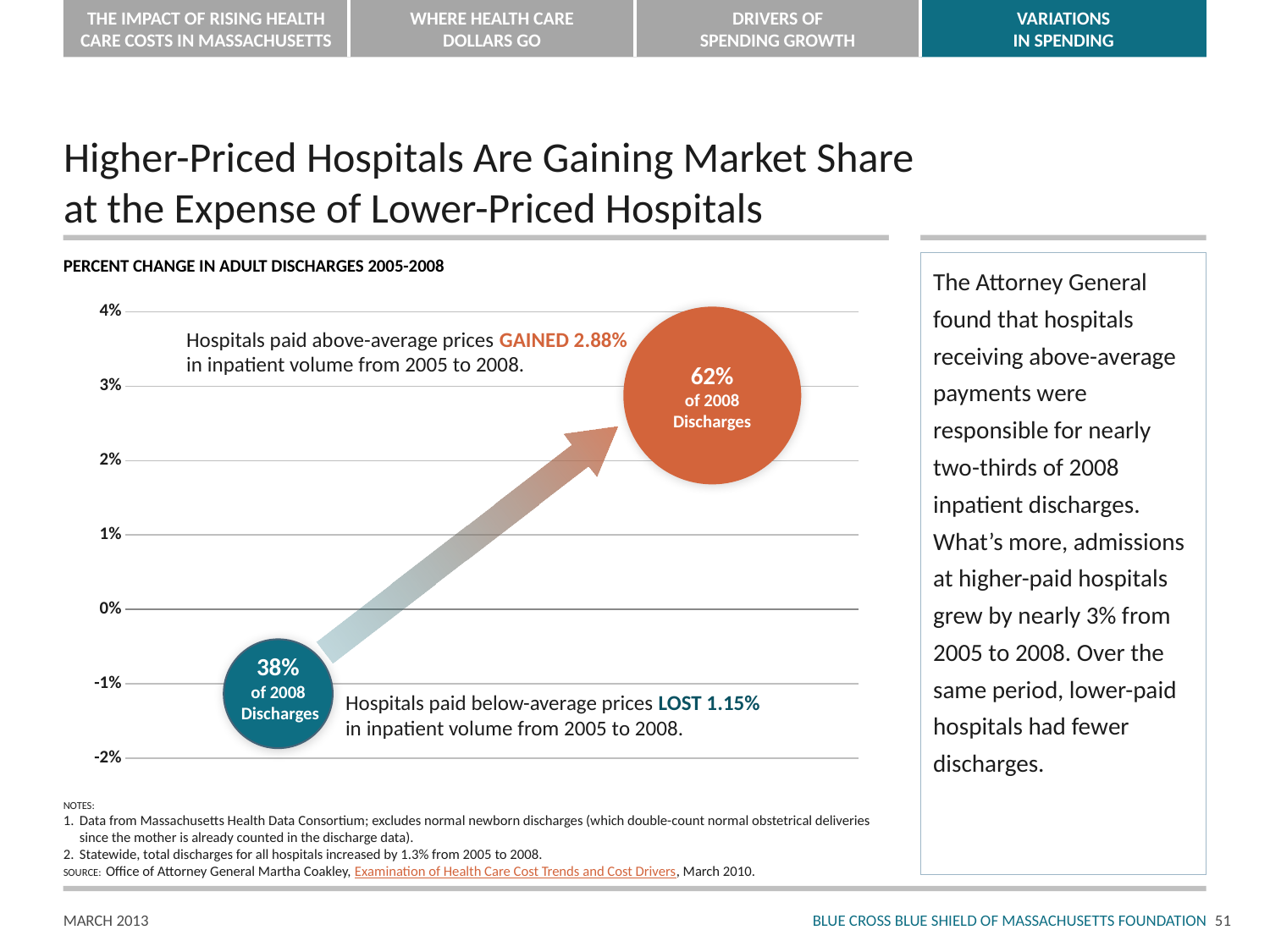
Is the change in inpatient volume for hospitals paid above-average prices greater or less than 2%? greater By what percent did hospitals paid below-average prices lose in inpatient volume from 2005 to 2008? 1.15% By what percent did hospitals paid above-average prices gain in inpatient volume from 2005 to 2008? 2.88% How many hospital groups are plotted on the chart? 2 What is the title of the chart? Percent Change in Adult Discharges 2005-2008 What share of 2008 discharges did hospitals paid below-average prices account for? 38% Which group of hospitals had the larger share of 2008 discharges, those paid above-average prices or those paid below-average prices? Hospitals paid above-average prices What share of 2008 discharges did hospitals paid above-average prices account for? 62% Do the two shares of 2008 discharges (62% and 38%) add up to 100%? Yes Is the change in inpatient volume for hospitals paid below-average prices greater or less than 0%? less What is the highest value shown on the vertical axis? 4% What is the difference between the 62% and 38% shares of 2008 discharges? 24 percentage points